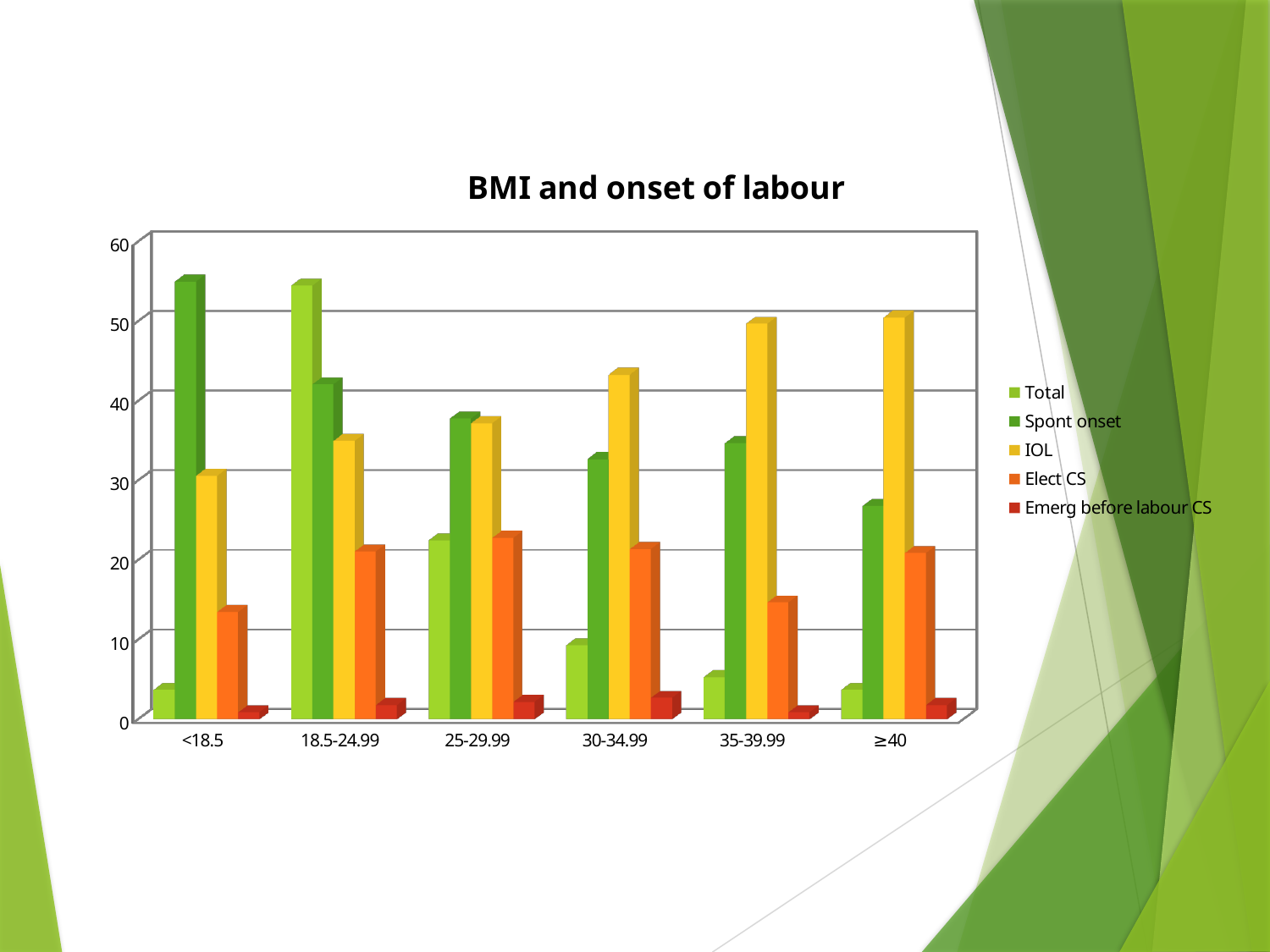
Which BMI category has the highest Spont onset value? <18.5 In the 35-39.99 category, which is larger: IOL or Spont onset? IOL Is the IOL value for <18.5 greater or less than 40? less Is the Spont onset value for <18.5 greater or less than 50? greater Which BMI category has the highest Total value? 18.5-24.99 How many series does the legend list? 5 Which BMI category has the lowest Spont onset value? ≥40 Do the IOL values rise or fall as BMI increases along the x axis? rise What kind of chart is shown on the slide? bar chart What is the title of the chart? BMI and onset of labour How many BMI categories are shown on the x axis? 6 Is the Total value for 18.5-24.99 greater or less than 50? greater